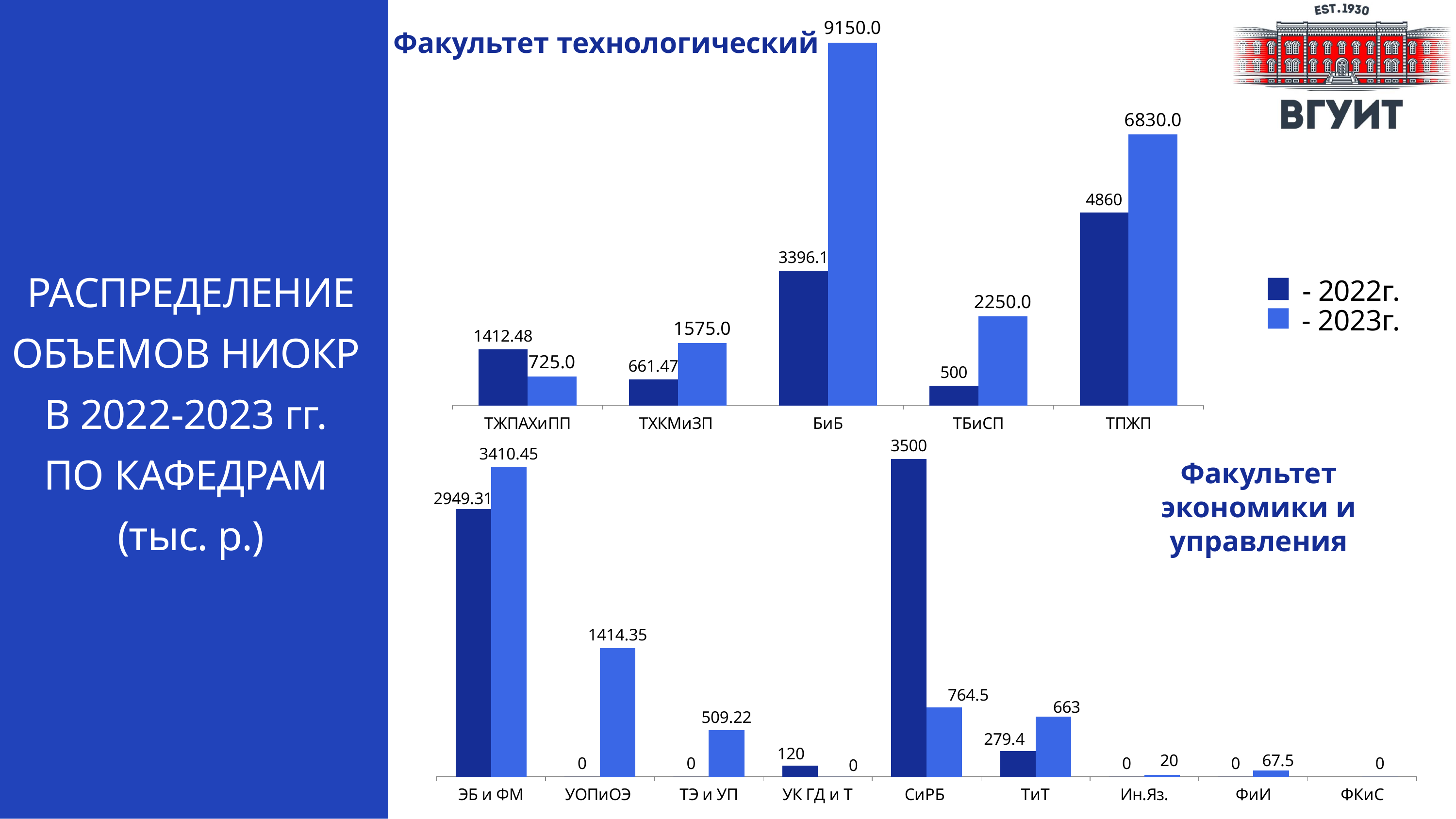
In the chart titled "Факультет экономики и управления", what is the value for СиРБ in 2022? 3500 In the chart titled "Факультет экономики и управления", how many categories are shown on the x axis? 9 How many series does the legend list for the charts on the slide? 2 In the chart titled "Факультет технологический", what is the value for ТЖПАХиПП in 2022? 1412.48 In the chart titled "Факультет экономики и управления", what is the difference between the 2022 and 2023 values for СиРБ? 2735.5 In the chart titled "Факультет экономики и управления", what is the value for УОПиОЭ in 2023? 1414.35 In the chart titled "Факультет технологический", which category has the highest 2022 value? ТПЖП In the chart titled "Факультет технологический", which category has the lowest 2023 value? ТЖПАХиПП In the chart titled "Факультет экономики и управления", which is larger for ТиТ: the 2022 value or the 2023 value? 2023 In the chart titled "Факультет технологический", what is the value for БиБ in 2023? 9150.0 In the chart titled "Факультет технологический", what is the difference between the 2023 and 2022 values for ТПЖП? 1970.0 In the chart titled "Факультет технологический", how many categories are shown on the x axis? 5